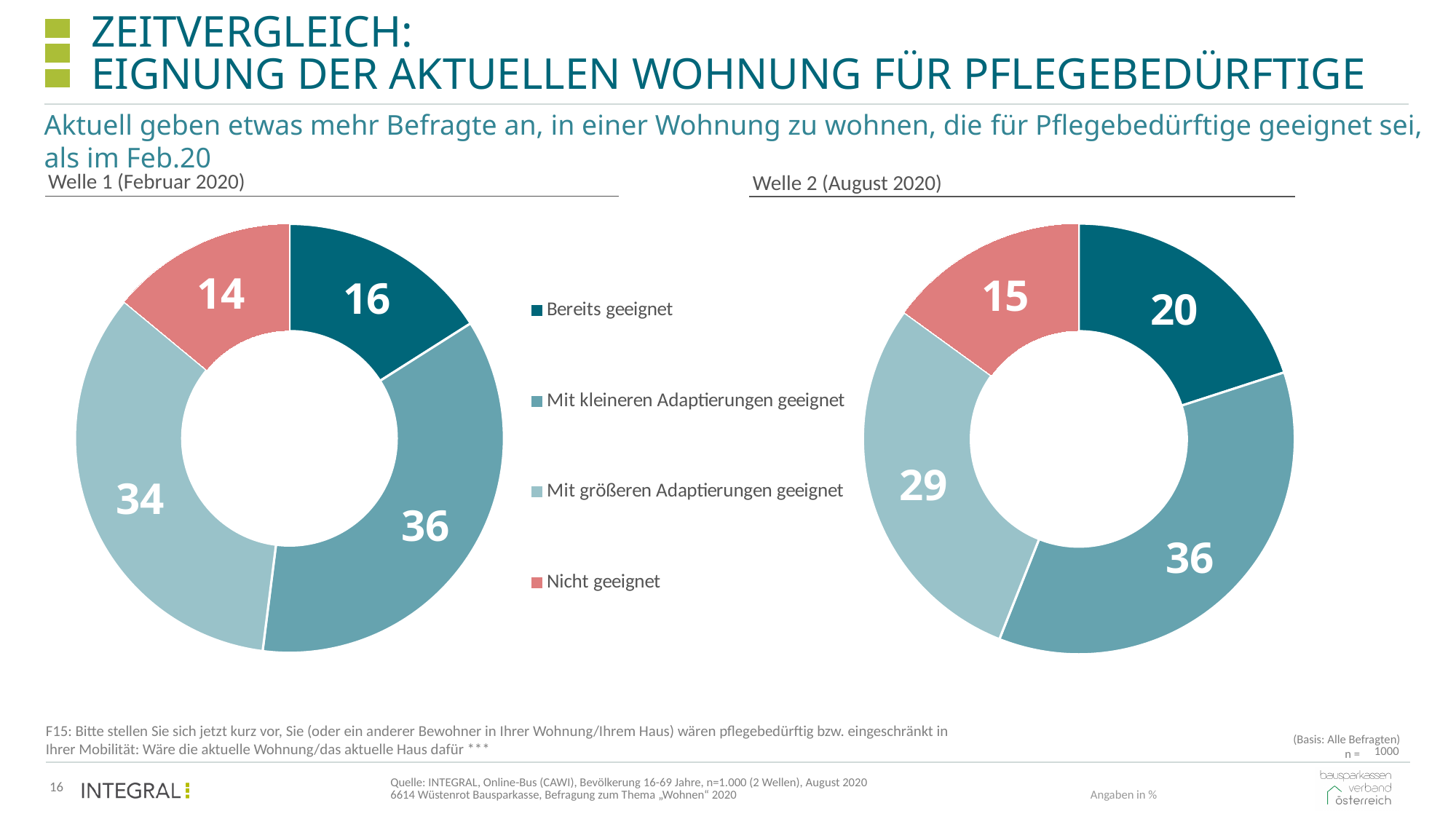
In the Welle 2 (August 2020) chart, what is the value for "Nicht geeignet"? 15 In the Welle 1 (Februar 2020) chart, which category has the largest share? Mit kleineren Adaptierungen geeignet What is the difference between the "Bereits geeignet" value in Welle 2 (August 2020) and in Welle 1 (Februar 2020)? 4 In the Welle 1 (Februar 2020) chart, what is the difference between "Mit kleineren Adaptierungen geeignet" and "Mit größeren Adaptierungen geeignet"? 2 Which colour represents "Nicht geeignet" in the legend? Red/pink In the Welle 1 (Februar 2020) chart, which category has the smallest share? Nicht geeignet How many categories does each donut chart show? 4 In the Welle 2 (August 2020) chart, what is the value for "Mit größeren Adaptierungen geeignet"? 29 What kind of chart is used for Welle 1 (Februar 2020)? Donut (pie) chart In the Welle 2 (August 2020) chart, which category has the smallest share? Nicht geeignet Is the value for "Mit größeren Adaptierungen geeignet" larger in Welle 1 (Februar 2020) or in Welle 2 (August 2020)? Welle 1 (Februar 2020) In the Welle 1 (Februar 2020) chart, what is the value for "Bereits geeignet"? 16